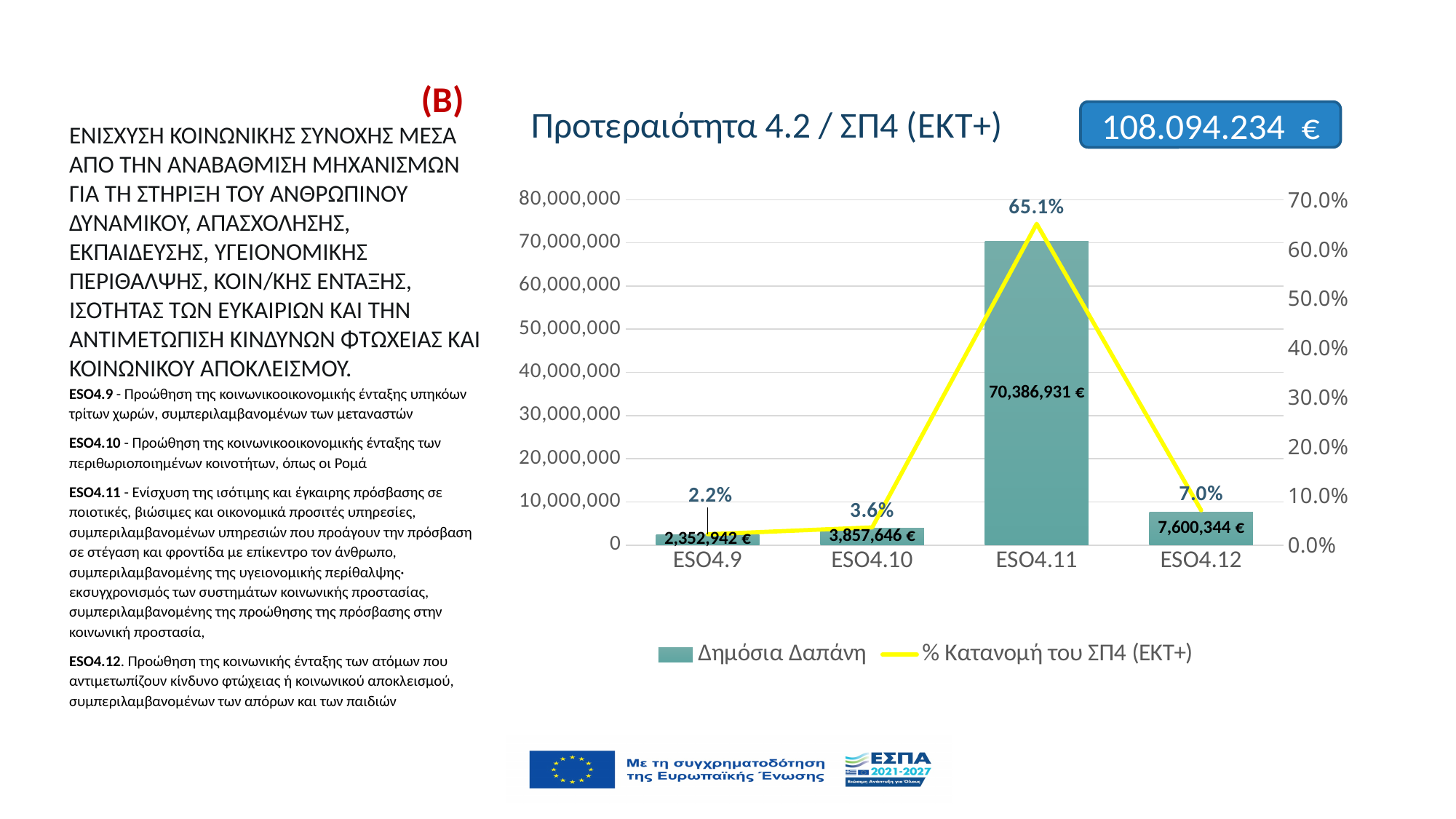
Which has a larger Δημόσια Δαπάνη, ESO4.10 or ESO4.12? ESO4.12 What is the Δημόσια Δαπάνη value for ESO4.9? 2,352,942 € What is the Δημόσια Δαπάνη value for ESO4.11? 70,386,931 € Which category has the highest Δημόσια Δαπάνη? ESO4.11 How many series does the chart legend list? 2 What kind of chart is shown on the slide? Combined bar and line chart How many categories are shown on the x axis of the chart? 4 What percentage (% Κατανομή του ΣΠ4 (ΕΚΤ+)) is shown for ESO4.12? 7.0% What percentage (% Κατανομή του ΣΠ4 (ΕΚΤ+)) is shown for ESO4.10? 3.6% Which category has the lowest Δημόσια Δαπάνη? ESO4.9 What is the difference in Δημόσια Δαπάνη between ESO4.12 and ESO4.10? 3,742,698 € Is the Δημόσια Δαπάνη for ESO4.11 greater or less than 60,000,000? greater